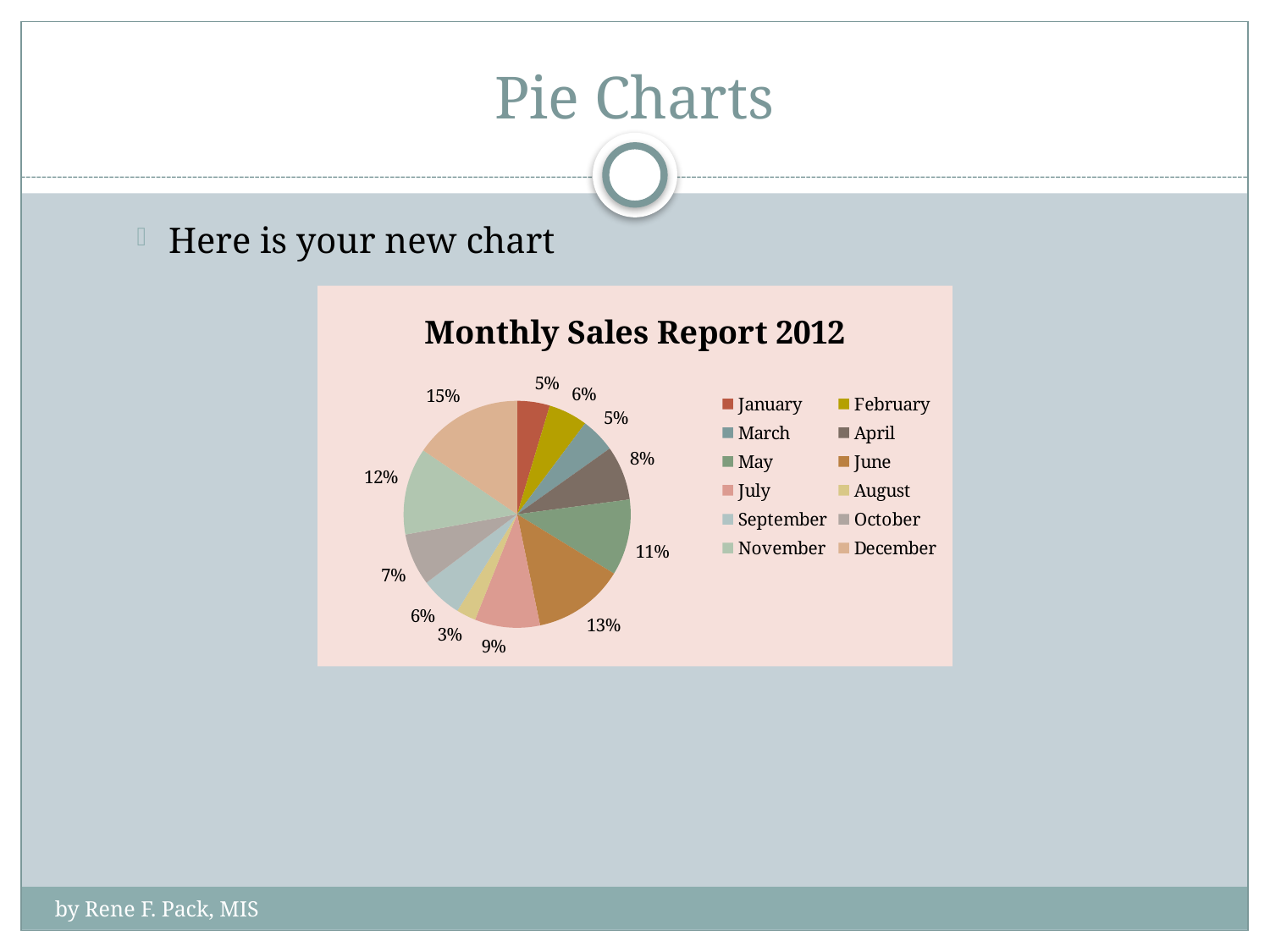
How many slices does the pie chart have? 12 What is the value shown for July? 9% What share of the pie does December represent? 15% What share of the pie does June represent? 13% What is the difference between the shares for December and August? 12% What kind of chart is shown on the slide? pie chart What is the title of the pie chart? Monthly Sales Report 2012 What is the value shown for April? 8% Which month has the smallest slice of the pie? August What share of the pie does August represent? 3% Which month has the largest slice of the pie? December Which is larger, the share for May or the share for November? November